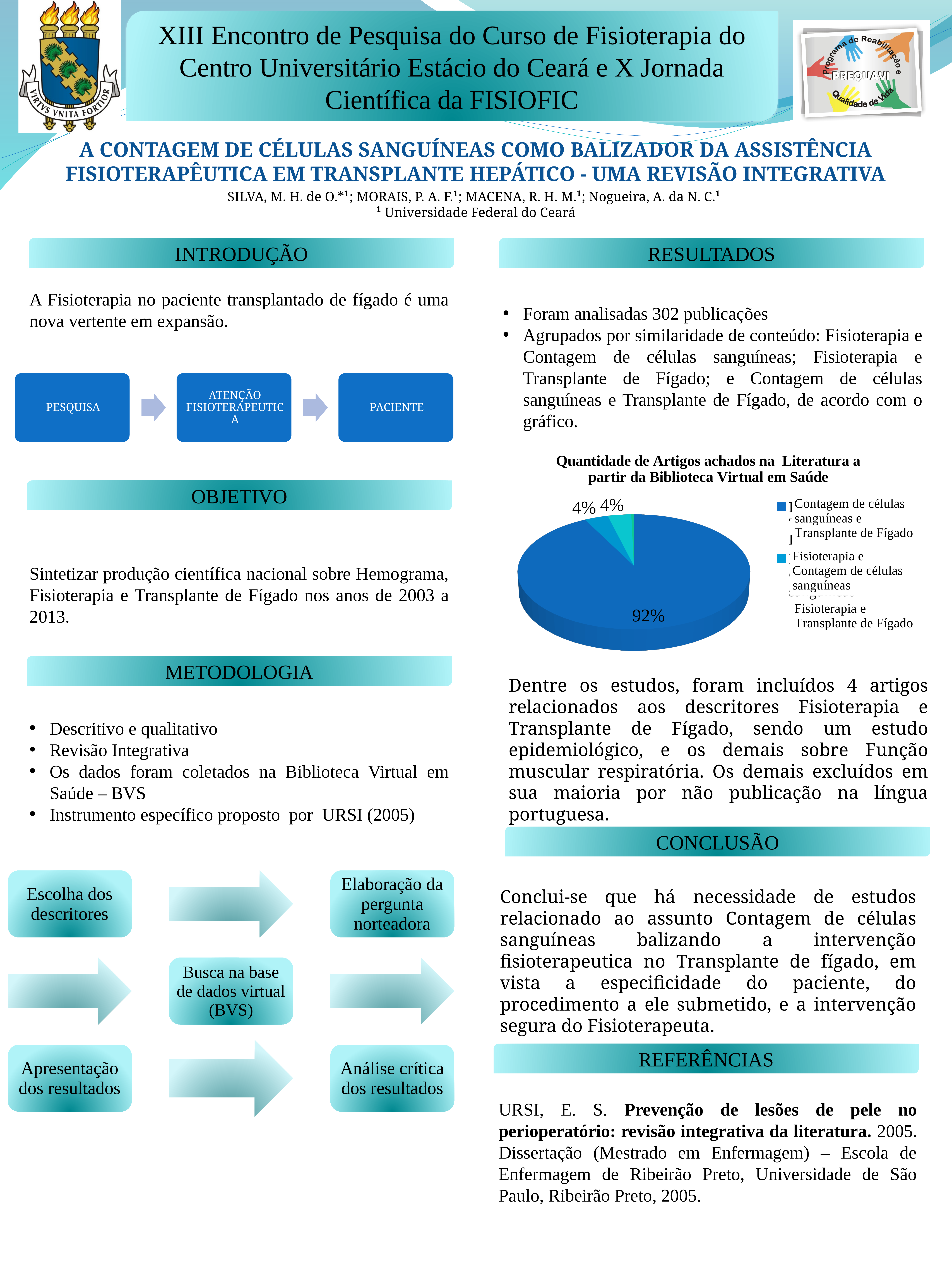
What is the difference in percentage points between the largest slice (92%) and the 'Fisioterapia e Transplante de Fígado' slice (4%)? 88 How many entries does the pie chart's legend list? 3 What share of the pie does 'Fisioterapia e Contagem de células sanguíneas' represent? 4% How many slices does the pie chart have? 3 Which is larger in the pie chart: 'Contagem de células sanguíneas e Transplante de Fígado' or 'Fisioterapia e Transplante de Fígado'? Contagem de células sanguíneas e Transplante de Fígado What colour is the largest slice of the pie chart? dark blue What share of the pie does 'Contagem de células sanguíneas e Transplante de Fígado' represent? 92% What is the title of the pie chart? Quantidade de Artigos achados na Literatura a partir da Biblioteca Virtual em Saúde Which category has the largest slice in the pie chart? Contagem de células sanguíneas e Transplante de Fígado What kind of chart is shown under the RESULTADOS section? pie chart What share of the pie does 'Fisioterapia e Transplante de Fígado' represent? 4%